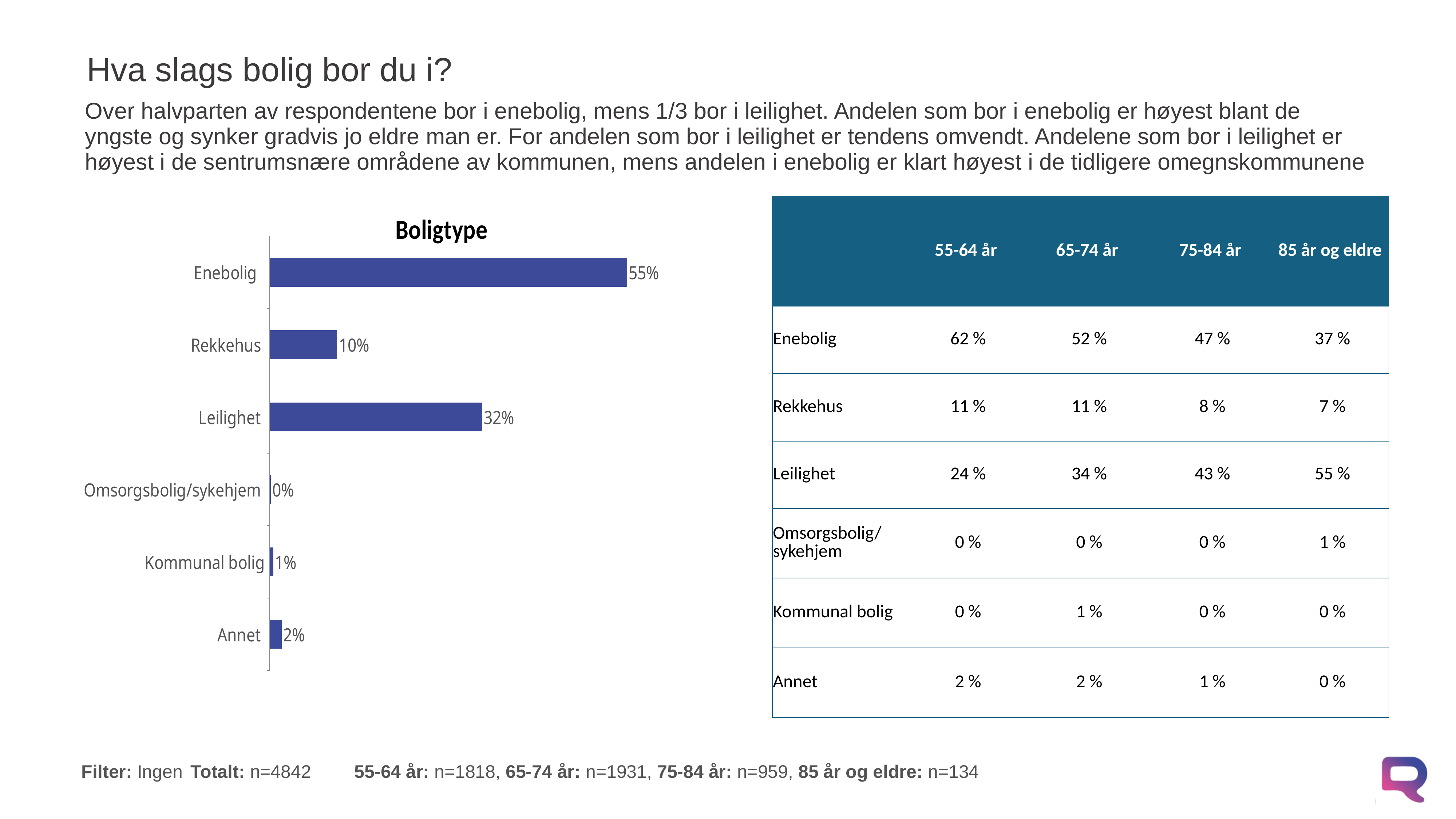
What type of chart is the Boligtype chart? Bar chart In the Boligtype chart, what is the value for Enebolig? 55% In the Boligtype chart, which category has the highest value? Enebolig In the Boligtype chart, what is the difference between the values for Rekkehus and Kommunal bolig? 9% What is the title of the chart on the slide? Boligtype In the Boligtype chart, what is the value for Leilighet? 32% How many categories are shown in the Boligtype chart? 6 In the Boligtype chart, which category has the lowest value? Omsorgsbolig/sykehjem In the Boligtype chart, what is the value for Rekkehus? 10% In the Boligtype chart, what is the difference between the values for Enebolig and Leilighet? 23% In the Boligtype chart, which is larger: Rekkehus or Leilighet? Leilighet In the Boligtype chart, what is the value for Annet? 2%